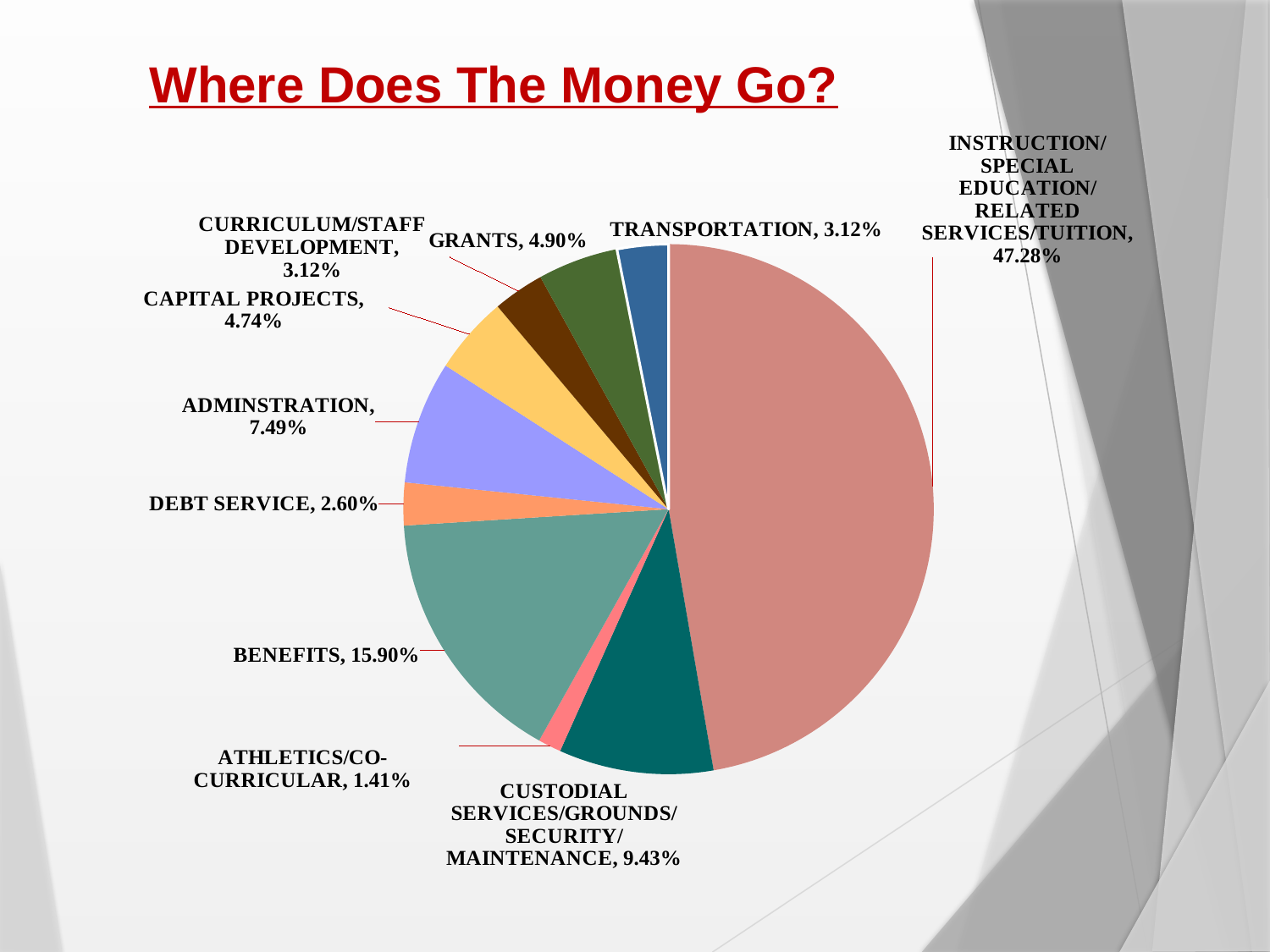
What percentage is shown for ADMINSTRATION? 7.49% What share of the pie goes to INSTRUCTION/SPECIAL EDUCATION/RELATED SERVICES/TUITION? 47.28% What is the difference between the BENEFITS share and the ADMINSTRATION share? 8.41% How many slices does the pie chart have? 10 Which category has the smallest slice of the pie? ATHLETICS/CO-CURRICULAR What kind of chart is shown on the slide? pie chart Which is larger, the share for GRANTS or the share for CAPITAL PROJECTS? GRANTS What percentage is shown for CUSTODIAL SERVICES/GROUNDS/SECURITY/MAINTENANCE? 9.43% What percentage is shown for DEBT SERVICE? 2.60% What share of the pie goes to BENEFITS? 15.90% Which category has the largest slice of the pie? INSTRUCTION/SPECIAL EDUCATION/RELATED SERVICES/TUITION What is the title of the slide's chart? Where Does The Money Go?